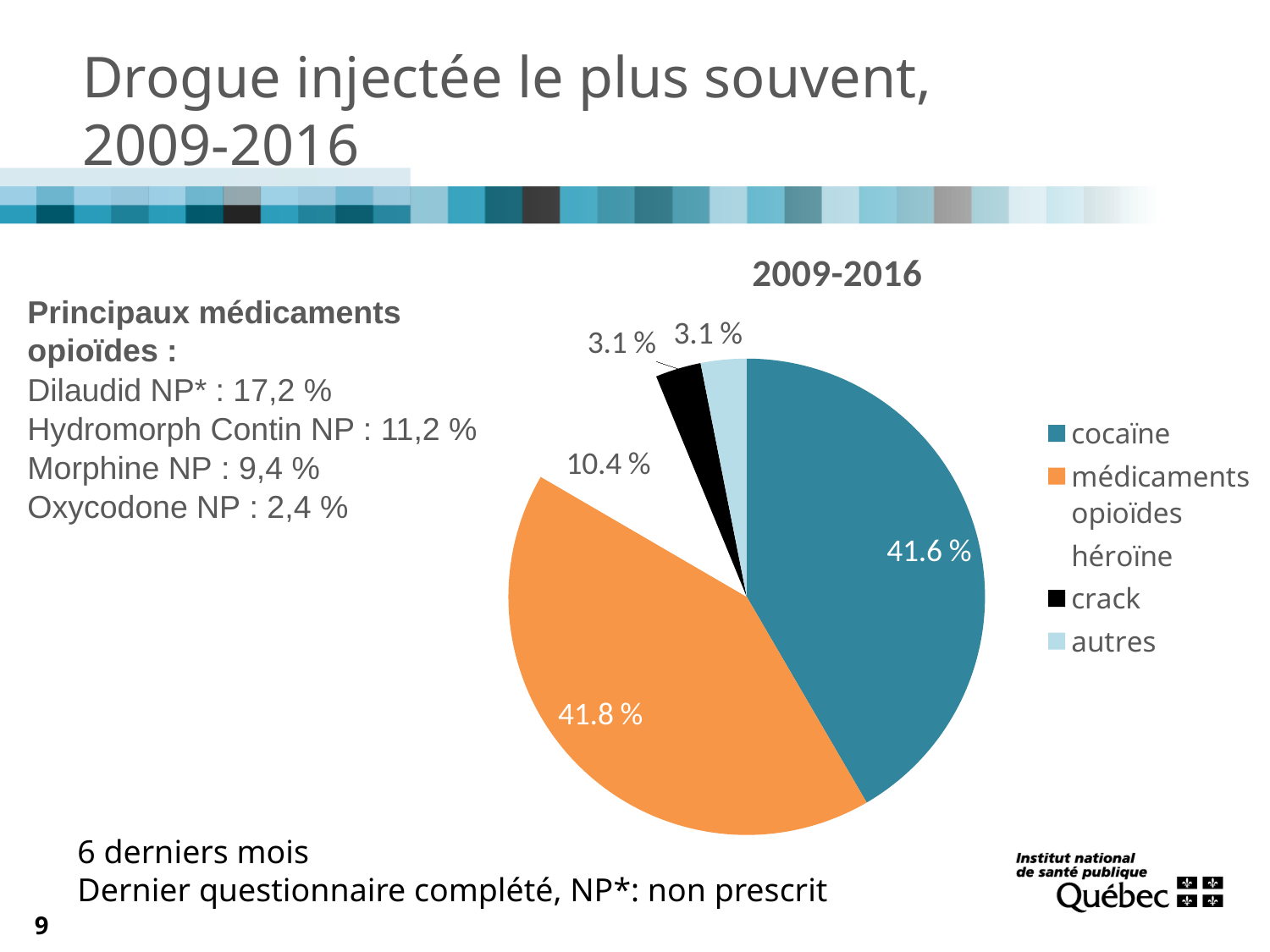
What is the title of the chart? 2009-2016 How many slices does the pie chart have? 5 What is the value for autres? 3.1 % What is the difference between the values for médicaments opioïdes and cocaïne? 0.2 % Which is larger, the slice for cocaïne or the slice for héroïne? cocaïne What type of chart is shown on the slide? pie chart What share of the pie does cocaïne represent? 41.6 % What is the value shown for médicaments opioïdes? 41.8 % What percentage is shown for héroïne? 10.4 % What is the difference between the values for cocaïne and héroïne? 31.2 % What is the value for crack? 3.1 % Which category has the largest slice of the pie? médicaments opioïdes